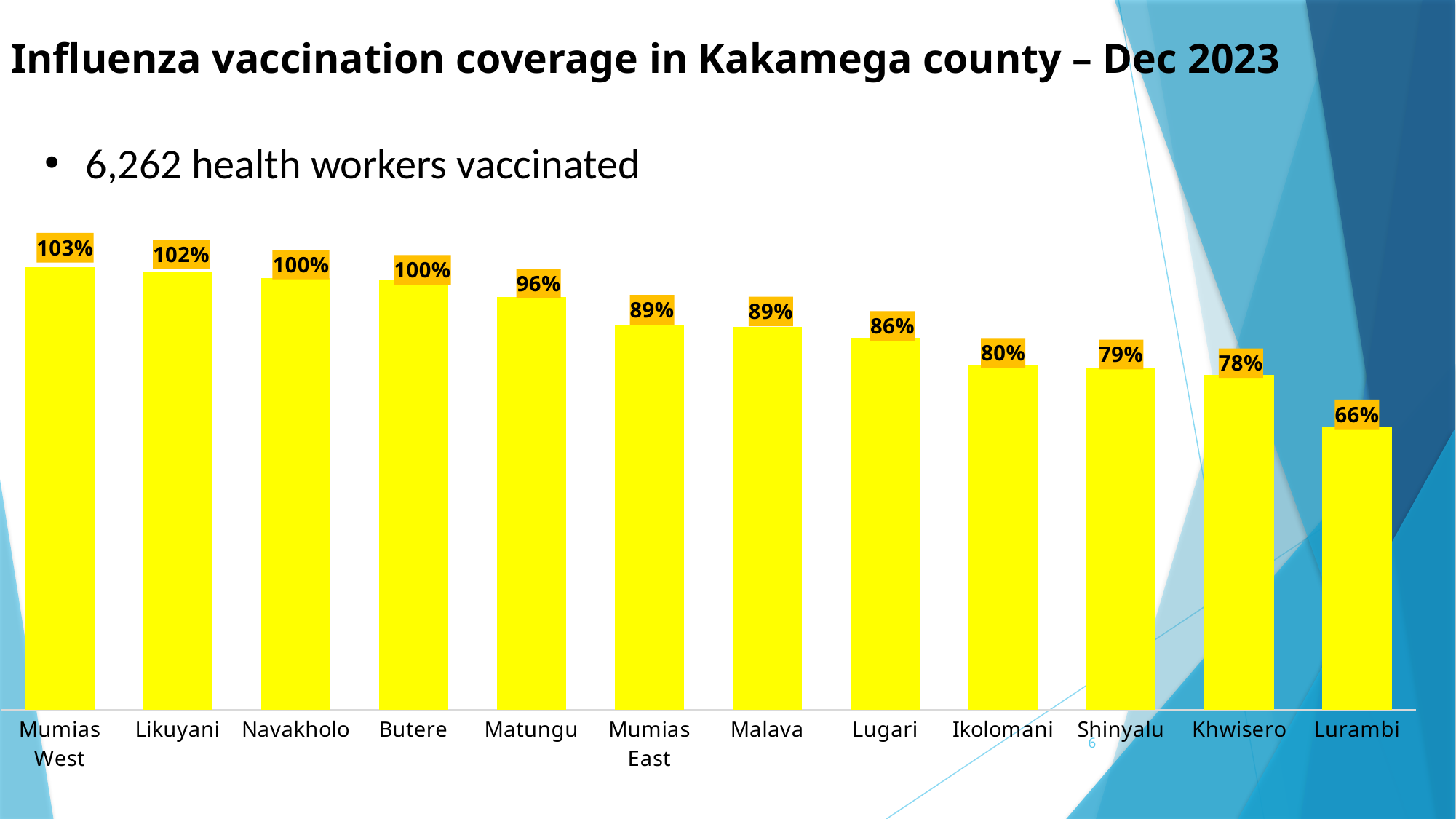
What is the vaccination coverage for Ikolomani? 80% What is the vaccination coverage for Lugari? 86% What colour are the bars in the chart? Yellow What kind of chart is shown on the slide? Bar chart What is the vaccination coverage for Matungu? 96% What is the difference in coverage between Mumias West and Lurambi? 37% Which has higher coverage, Khwisero or Matungu? Matungu Which sub-county has the lowest vaccination coverage? Lurambi What is the difference in coverage between Likuyani and Shinyalu? 23% Do the values rise or fall from left to right across the chart? Fall Which sub-county has the highest vaccination coverage? Mumias West How many sub-counties are shown in the chart? 12